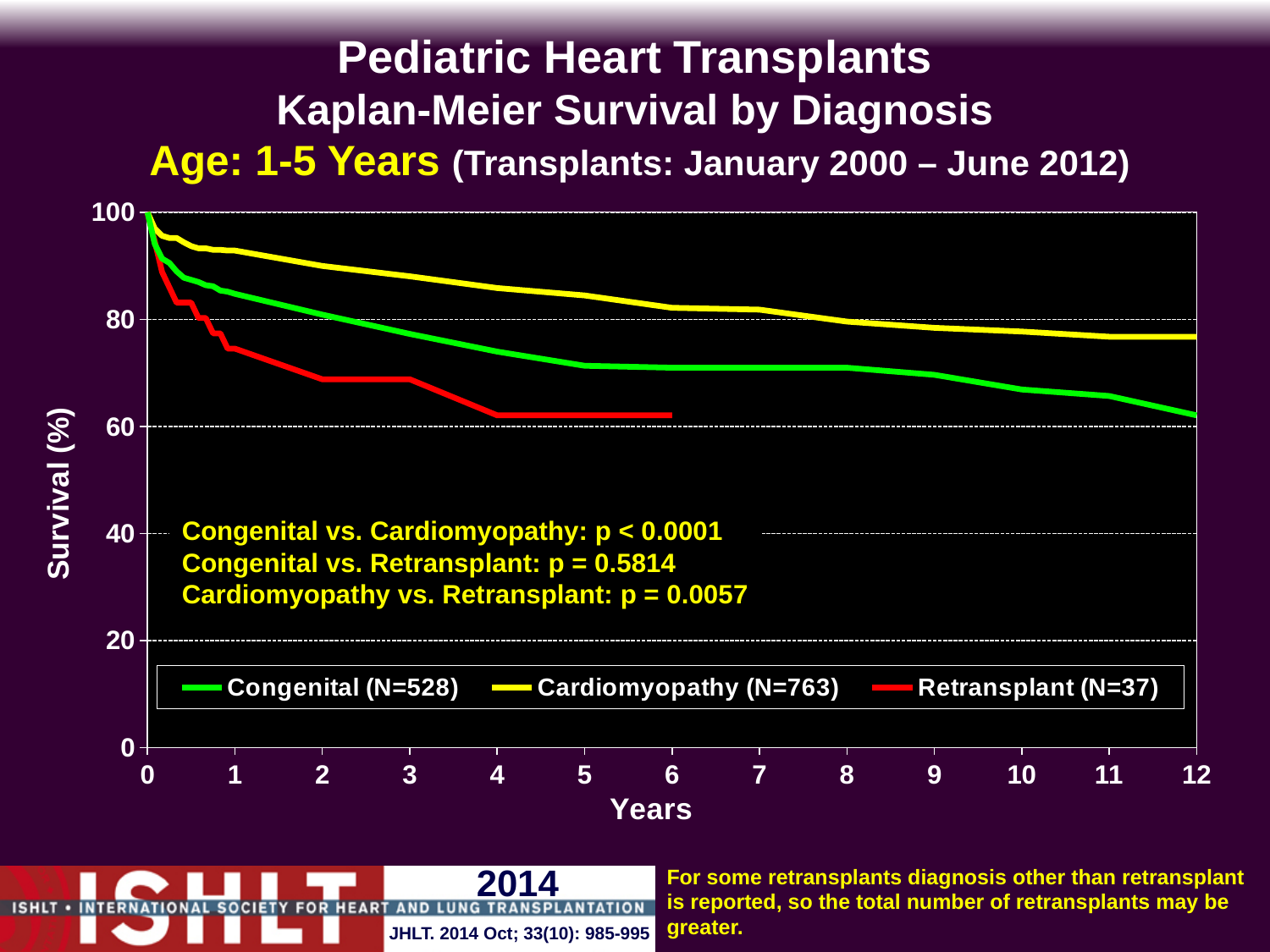
What is the N for the Cardiomyopathy group shown in the legend? 763 Is the survival for Retransplant at 2 years greater or less than 80? less At 6 years, which group has higher survival, Cardiomyopathy or Congenital? Cardiomyopathy What kind of chart is shown on the slide? Line chart Is the survival for Cardiomyopathy at 1 year greater or less than 80? greater Which diagnosis group has the lowest survival across the follow-up period? Retransplant Which diagnosis group has the highest survival across the follow-up period? Cardiomyopathy Is the survival for Cardiomyopathy at 12 years greater or less than 80? less At 3 years, which group has higher survival, Congenital or Retransplant? Congenital How many series does the legend list? 3 Do the survival curves rise or fall as years increase? Fall